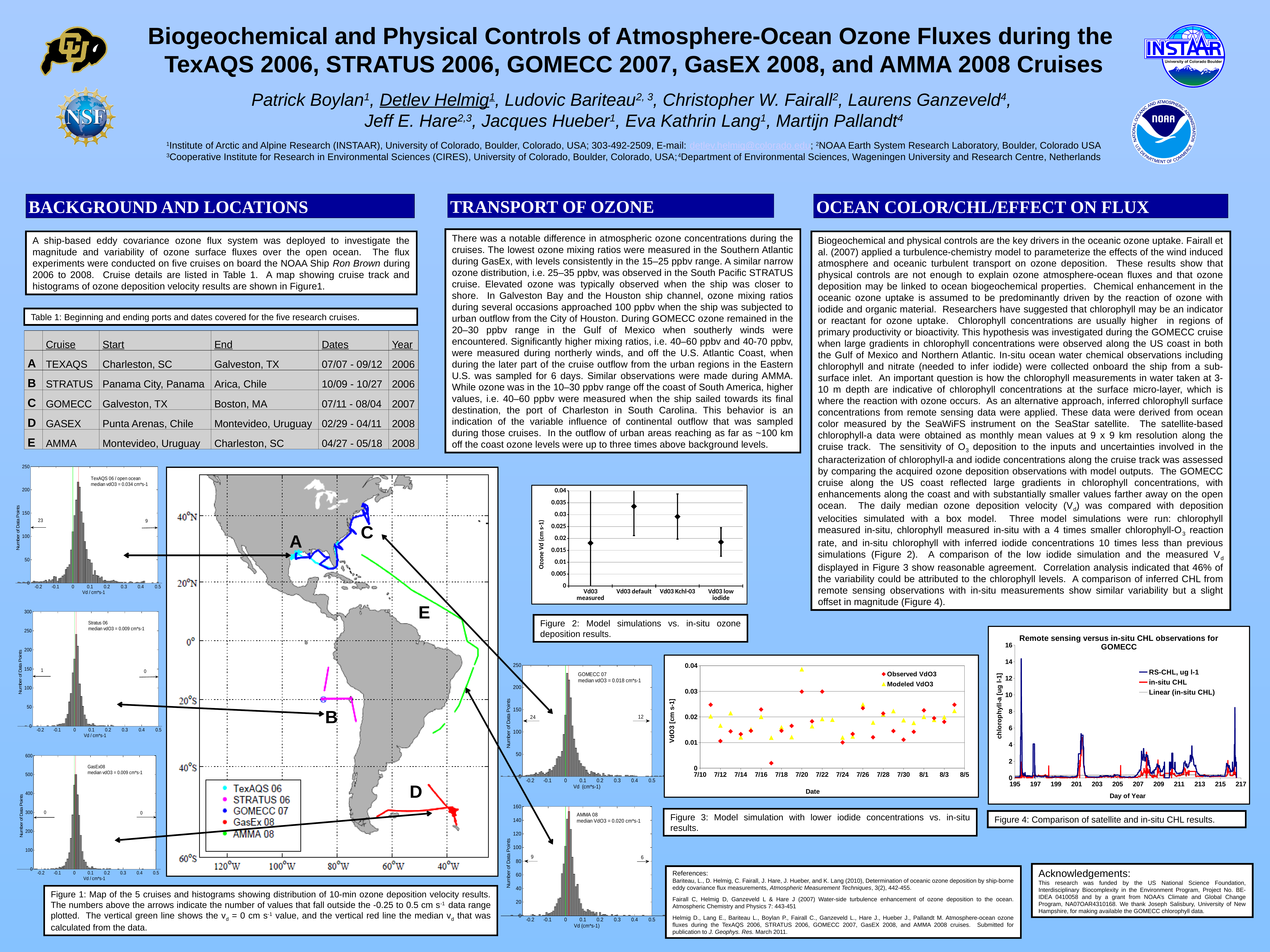
In Figure 2 (Model simulations vs. in-situ ozone deposition results), how many categories are shown on the x axis? 4 In the GOMECC 07 histogram in Figure 1, what is the median vdO3 value printed on the chart? 0.018 cm*s-1 In Figure 4, what is the label of the y axis? chlorophyll-a [ug l-1] In Figure 4 (Remote sensing versus in-situ CHL observations for GOMECC), how many series does the legend list? 3 In the GOMECC 07 histogram in Figure 1, how many values fall above the plotted range, according to the number above the right arrow? 12 In Figure 2, is the central value for Vd03 default greater or less than 0.03? greater In Figure 3, how many series does the legend list? 2 In Figure 2, is the central value for Vd03 measured greater or less than 0.025? less In the AMMA 08 histogram in Figure 1, what is the median VdO3 value printed on the chart? 0.020 cm*s-1 In Figure 2, which category has the highest central Ozone Vd value? Vd03 default In the TexAQS 06 histogram in Figure 1, what is the median vdO3 value printed on the chart? 0.034 cm*s-1 In the TexAQS 06 histogram in Figure 1, how many values fall below the plotted range, according to the number above the left arrow? 23